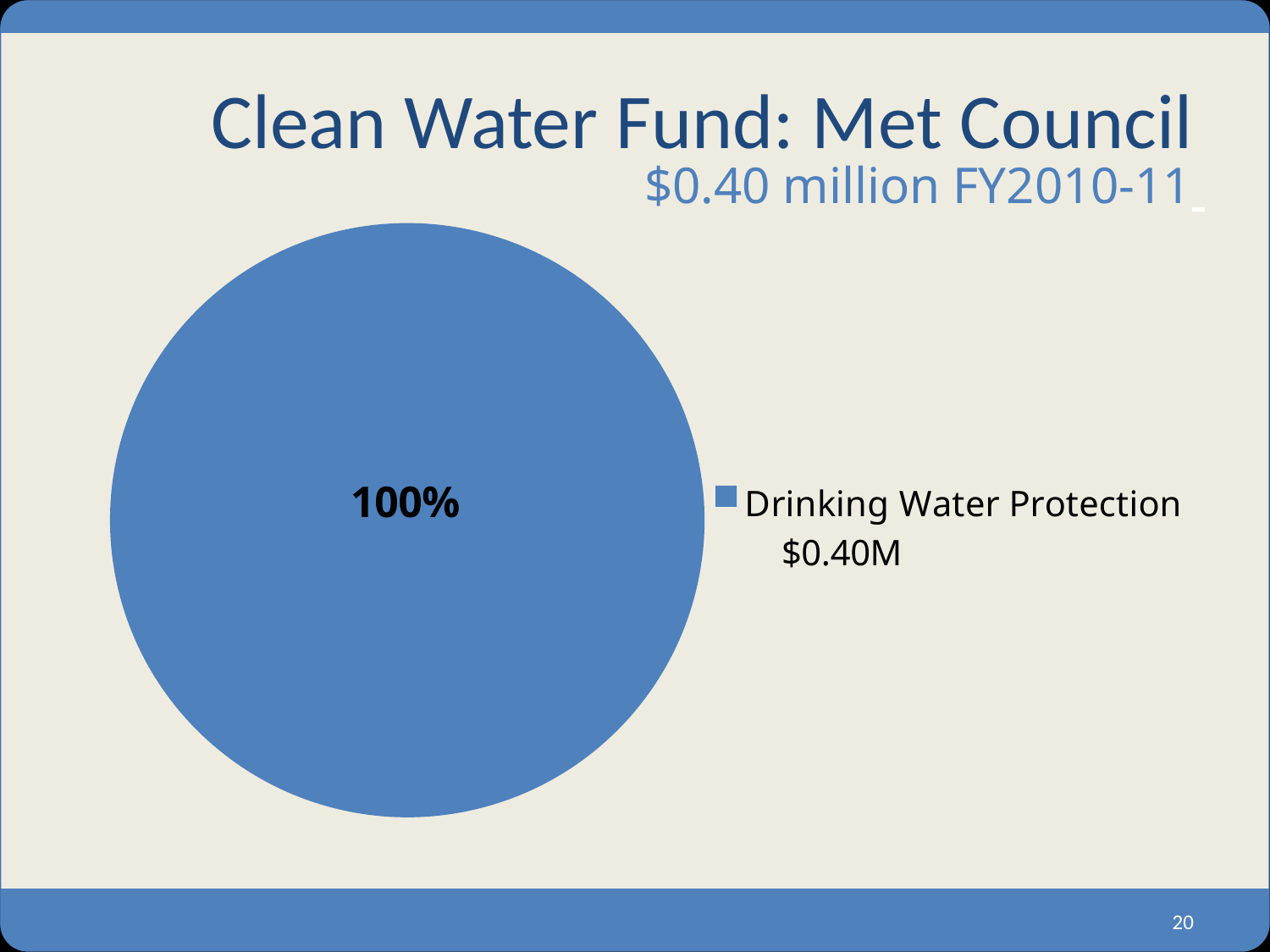
What total amount and fiscal years are given in the slide subtitle? $0.40 million FY2010-11 What kind of chart is shown on the slide? pie chart What share of the pie does Drinking Water Protection represent? 100% What is the name of the only category in the pie chart? Drinking Water Protection How many entries does the legend list? 1 How many slices does the pie chart have? 1 What dollar amount is shown in the legend for Drinking Water Protection? $0.40M